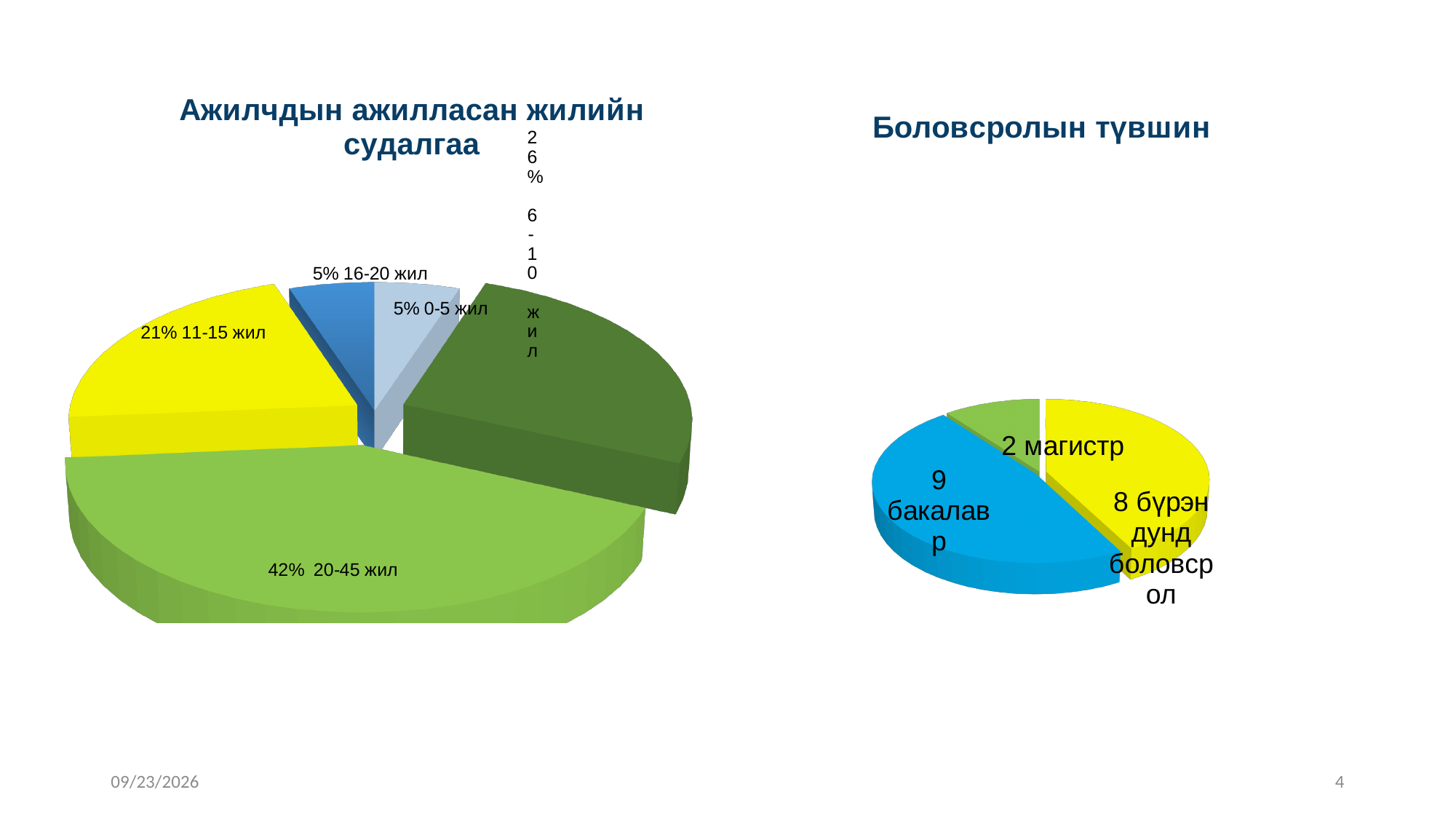
In the chart titled "Ажилчдын ажилласан жилийн судалгаа", what percentage of employees have worked 11-15 жил? 21% In the chart titled "Боловсролын түвшин", what is the difference between the value for бакалавр and the value for бүрэн дунд боловсрол? 1 In the chart titled "Ажилчдын ажилласан жилийн судалгаа", which category has the largest share? 20-45 жил In the chart titled "Боловсролын түвшин", what is the value for бакалавр? 9 In the chart titled "Боловсролын түвшин", what is the value for магистр? 2 In the chart titled "Ажилчдын ажилласан жилийн судалгаа", which is larger: the 6-10 жил slice or the 11-15 жил slice? 6-10 жил In the chart titled "Боловсролын түвшин", which category has the smallest value? магистр What type of chart is the chart titled "Боловсролын түвшин"? Pie chart In the chart titled "Ажилчдын ажилласан жилийн судалгаа", what percentage of employees have worked 20-45 жил? 42% In the chart titled "Ажилчдын ажилласан жилийн судалгаа", what percentage of employees have worked 6-10 жил? 26% In the chart titled "Ажилчдын ажилласан жилийн судалгаа", what is the difference in percentage points between the 20-45 жил slice and the 11-15 жил slice? 21 In the chart titled "Ажилчдын ажилласан жилийн судалгаа", how many slices does the pie have? 5